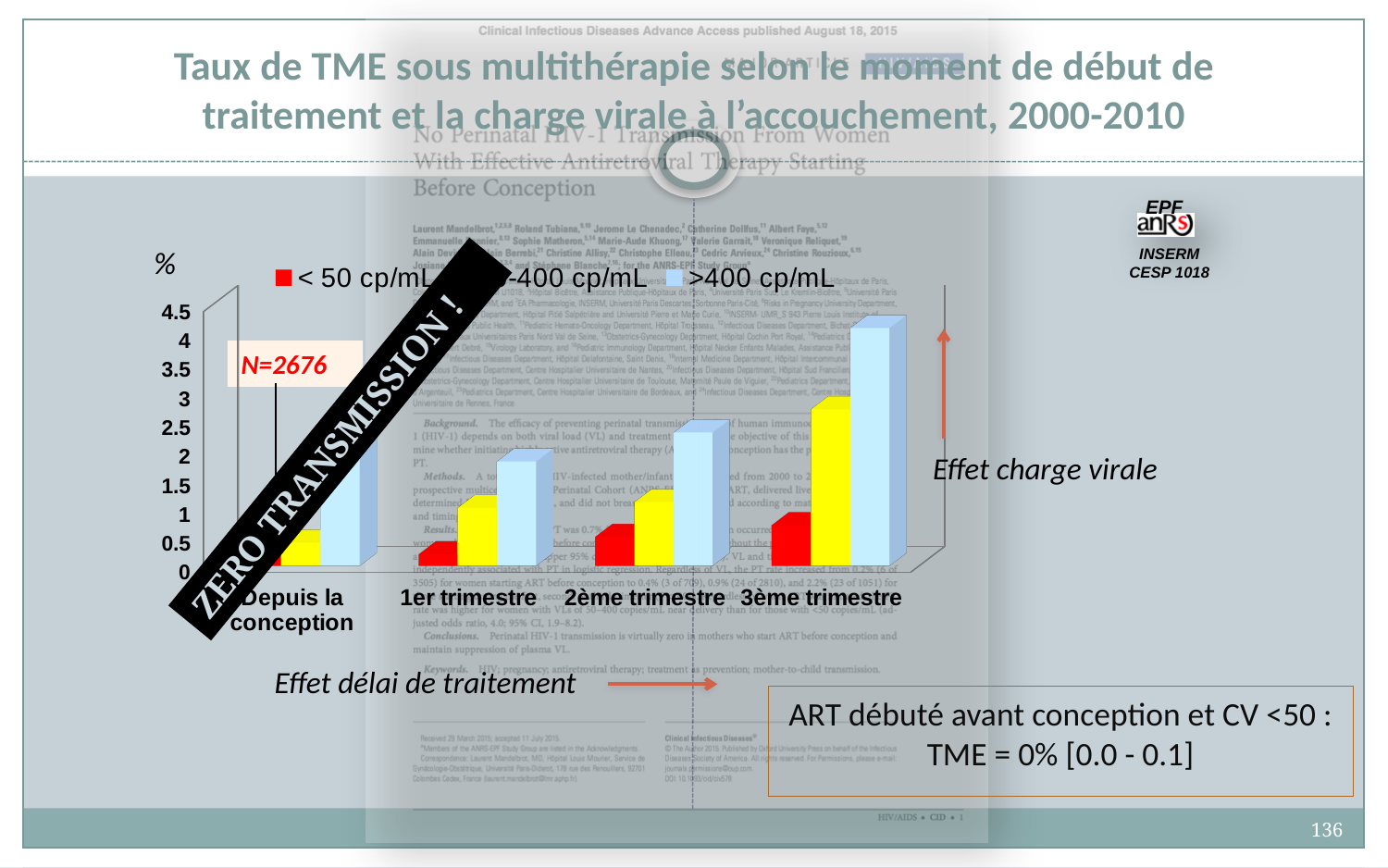
Which category has the tallest bar for the >400 cp/mL series? 3ème trimestre Is the value for >400 cp/mL in the 3ème trimestre greater or less than 3? greater Within the 3ème trimestre category, which series has the lowest bar? < 50 cp/mL How many series does the chart's legend list? 3 How many categories are shown along the x axis of the chart? 4 Do the >400 cp/mL values rise or fall from 'Depuis la conception' to '3ème trimestre'? rise What kind of chart is shown on the slide? bar chart What sample size (N) is printed on the chart? N=2676 What unit is shown on the y axis of the chart? % Is the value for < 50 cp/mL in the 1er trimestre greater or less than 1? less Is the value for >400 cp/mL in the 1er trimestre greater or less than 3? less Which is larger: the >400 cp/mL bar in the 2ème trimestre or the >400 cp/mL bar in the 3ème trimestre? 3ème trimestre